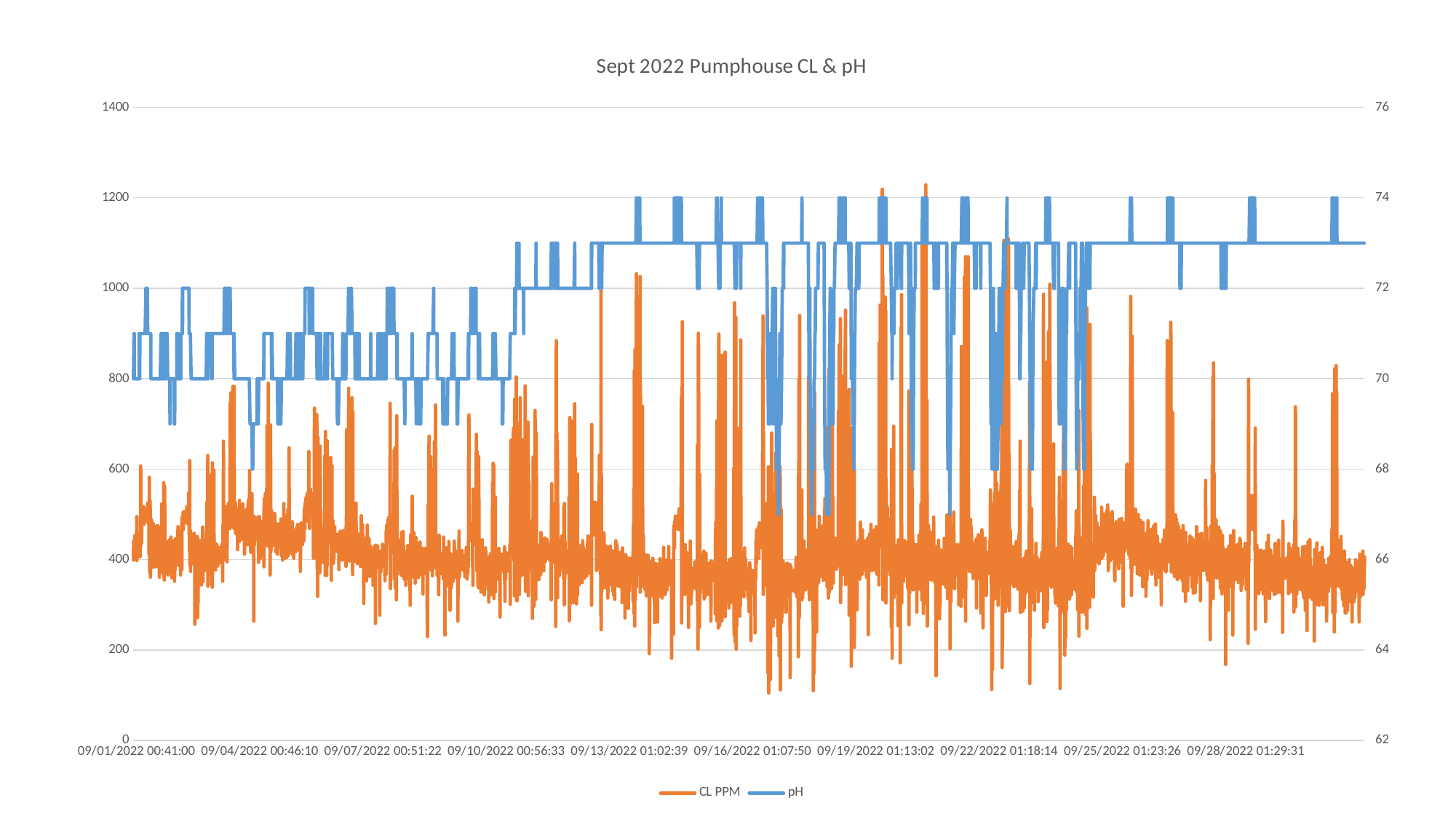
What is the maximum value shown on the left vertical axis? 1400 Which series is drawn in orange? CL PPM Is the highest CL PPM value reached during the month greater or less than 1400? less How many date labels are shown along the x axis? 10 How many series does the legend list? 2 Is the pH value at the end of the month (around 09/28/2022) greater or less than 72? greater Does the pH series generally rise or fall from the start of September to the end of September? Rise What kind of chart is shown on the slide? Line chart What is the maximum value shown on the right vertical axis? 76 What is the title of the chart? Sept 2022 Pumphouse CL & pH What is the minimum value shown on the right vertical axis? 62 Is the pH value at the start of the month (around 09/01/2022) greater or less than 72? less